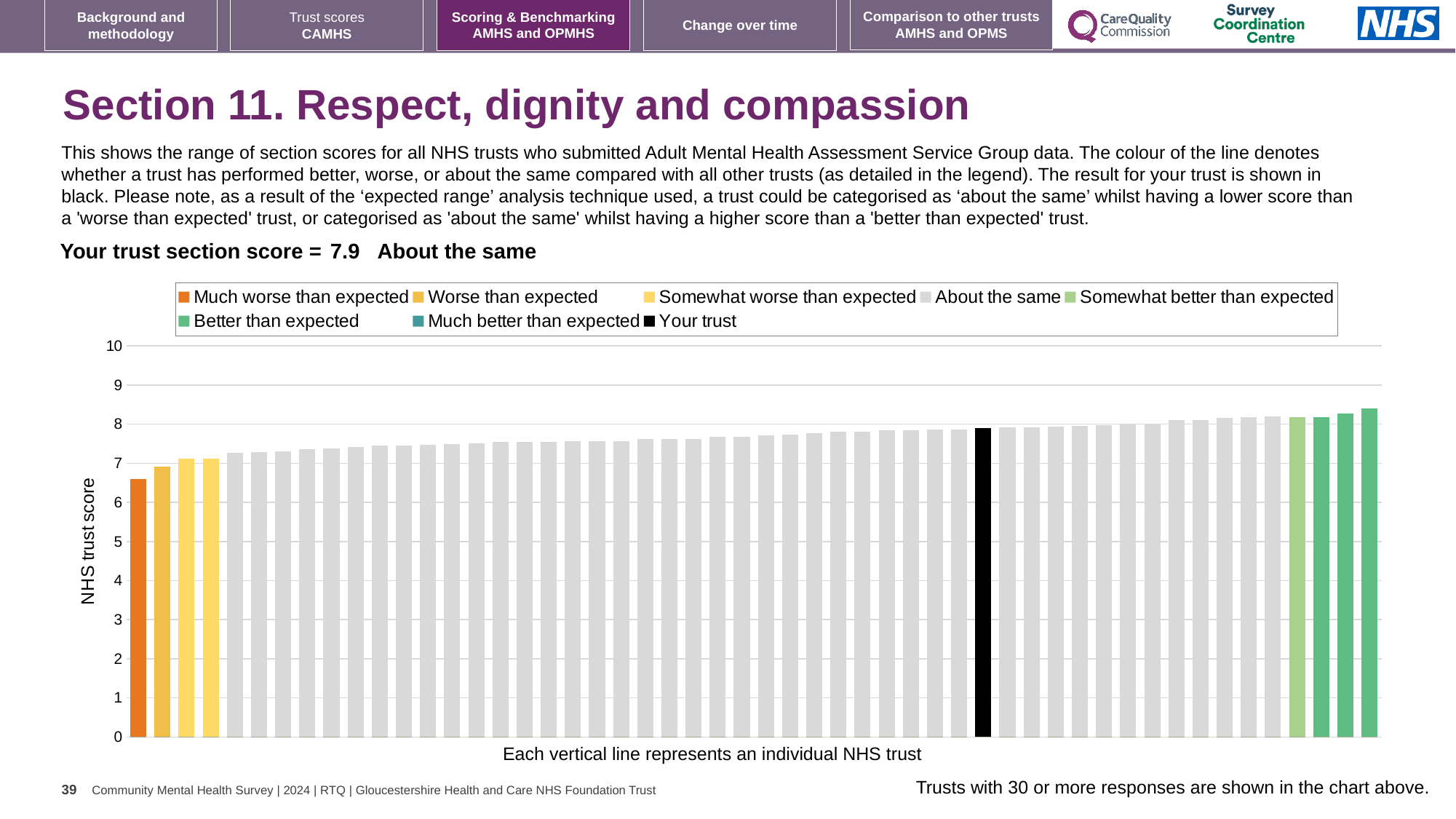
Is the value of the highest bar on the chart greater or less than 8? greater How many entries does the chart legend list? 8 Which legend category does the lowest bar on the chart belong to? Much worse than expected Is the value of the lowest bar (the orange 'Much worse than expected' trust) greater or less than 7? less What is the label on the y axis of the chart? NHS trust score Is the value for your trust (the black bar) greater or less than 7? greater Which legend category does the highest bar on the chart belong to? Better than expected Which category is your trust placed in for this section? About the same How many bars are coloured as 'Much worse than expected'? 1 What kind of chart is shown on the slide? Bar chart Do the bar values rise or fall moving from left to right along the x axis? rise What is the section score for your trust shown on the slide? 7.9